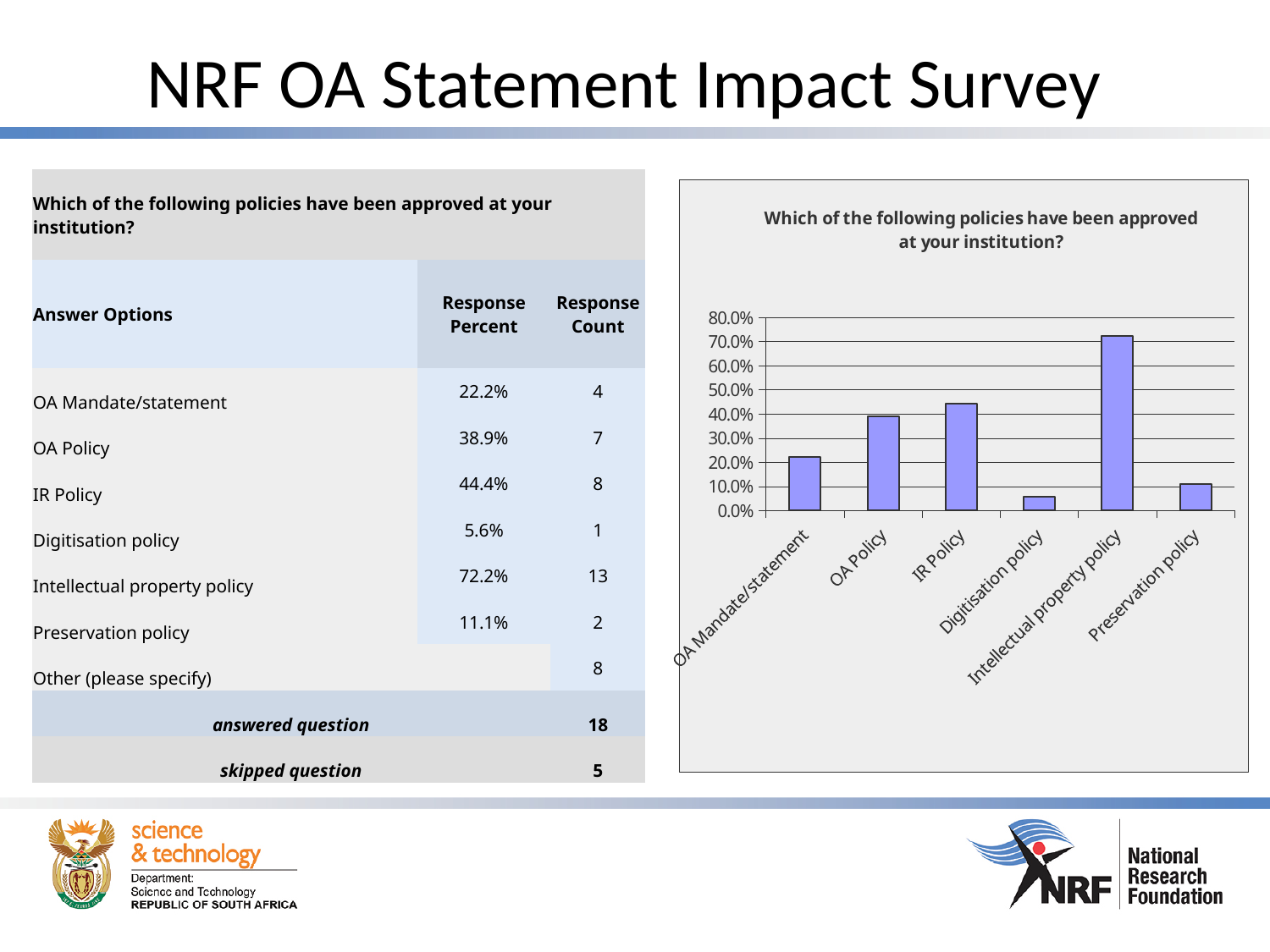
What is the response percent for Intellectual property policy? 72.2% What is the response percent for Preservation policy? 11.1% How many categories are plotted in the chart? 6 What is the difference in response percent between Intellectual property policy and IR Policy? 27.8% Which policy has the highest response percent in the chart? Intellectual property policy Is the value for OA Policy greater or less than 30.0%? greater Which policy has the lowest response percent in the chart? Digitisation policy What is the title of the chart? Which of the following policies have been approved at your institution? What type of chart is shown on the slide? bar chart Which has a higher response percent, OA Policy or IR Policy? IR Policy Is the value for OA Mandate/statement greater or less than 30.0%? less What is the response percent for IR Policy? 44.4%